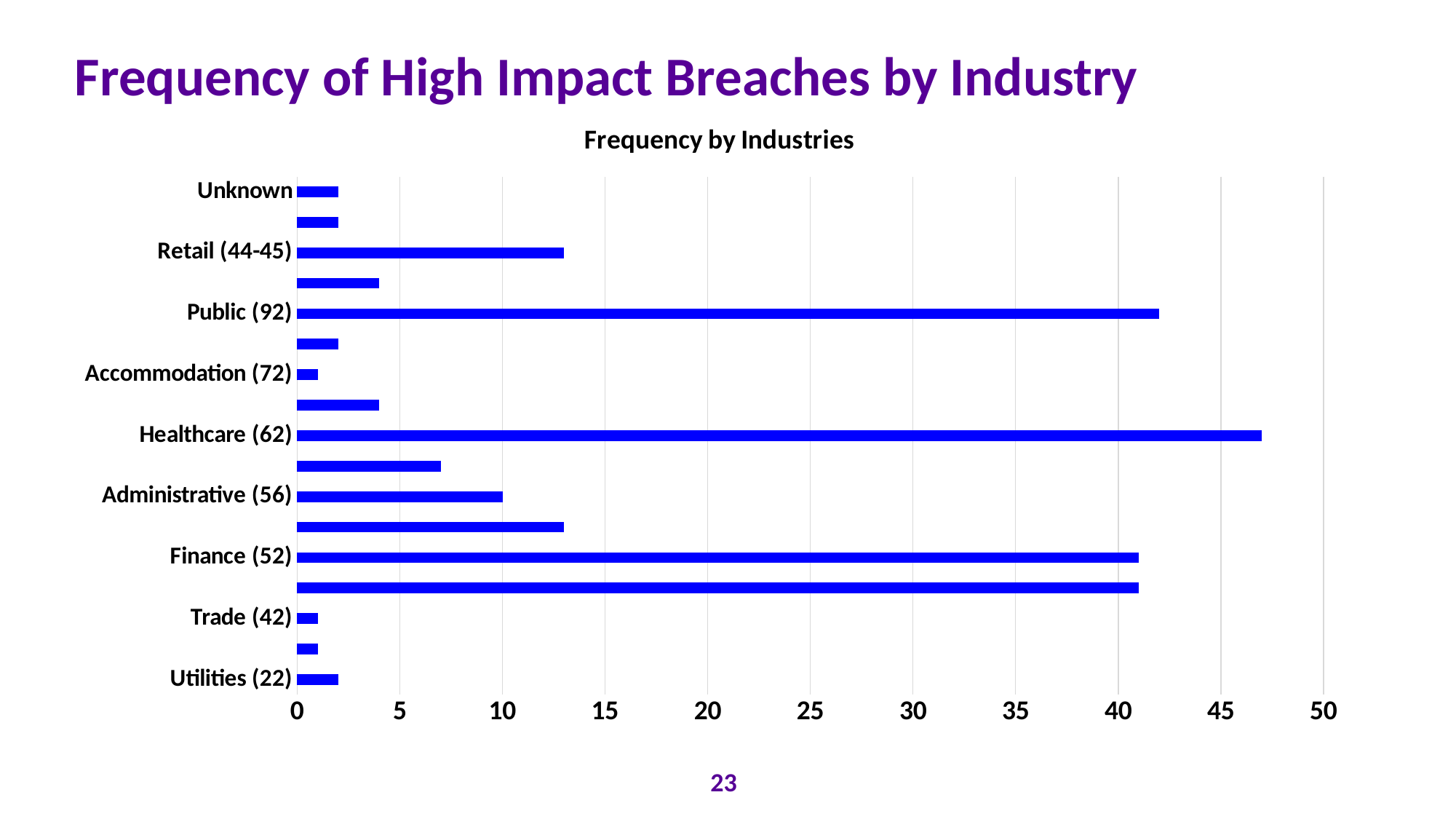
Is the value for Accommodation (72) greater or less than 5? less Which has a higher frequency, Retail (44-45) or Administrative (56)? Retail (44-45) What is the title of the chart? Frequency by Industries Is the value for Retail (44-45) greater or less than 10? greater Which labeled industry has the highest frequency? Healthcare (62) What kind of chart is shown on the slide? bar chart Which has a higher frequency, Healthcare (62) or Public (92)? Healthcare (62) Is the value for Finance (52) greater or less than 40? greater How many category labels are shown on the vertical axis of the chart? 9